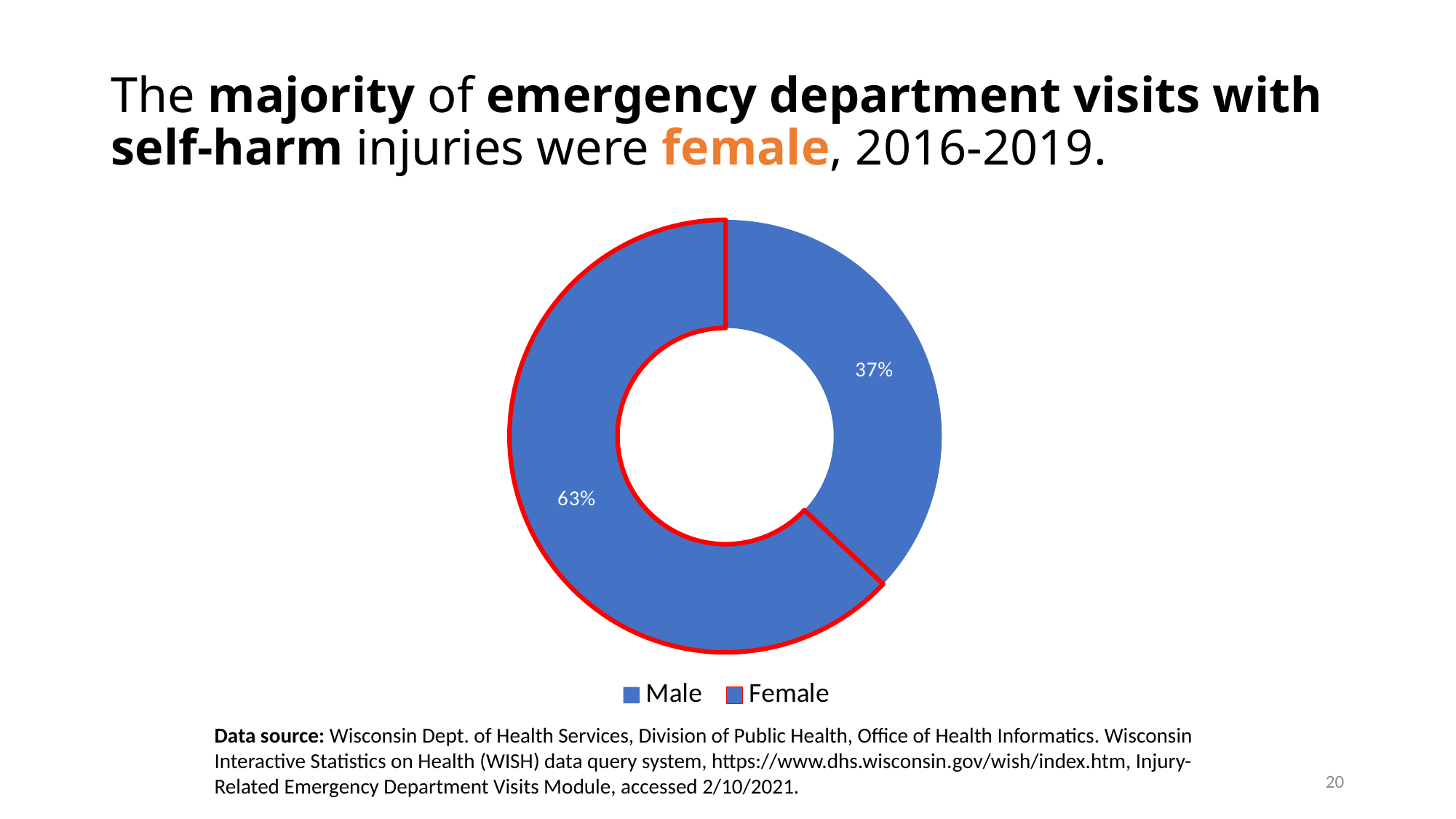
How many categories are shown in the chart? 2 Is the Male share larger or smaller than the Female share? smaller What percentage of emergency department visits with self-harm injuries were male? 37% What percentage of emergency department visits with self-harm injuries were female? 63% Which category has the larger share of the chart, Male or Female? Female What is the difference in percentage points between the Female and Male shares? 26 percentage points Which category has the smaller share of the chart? Male What kind of chart is shown on the slide? Doughnut (pie) chart What time period does the slide title say the data covers? 2016-2019 What is the total of the two shares shown in the chart? 100% Which legend entry is outlined in red? Female